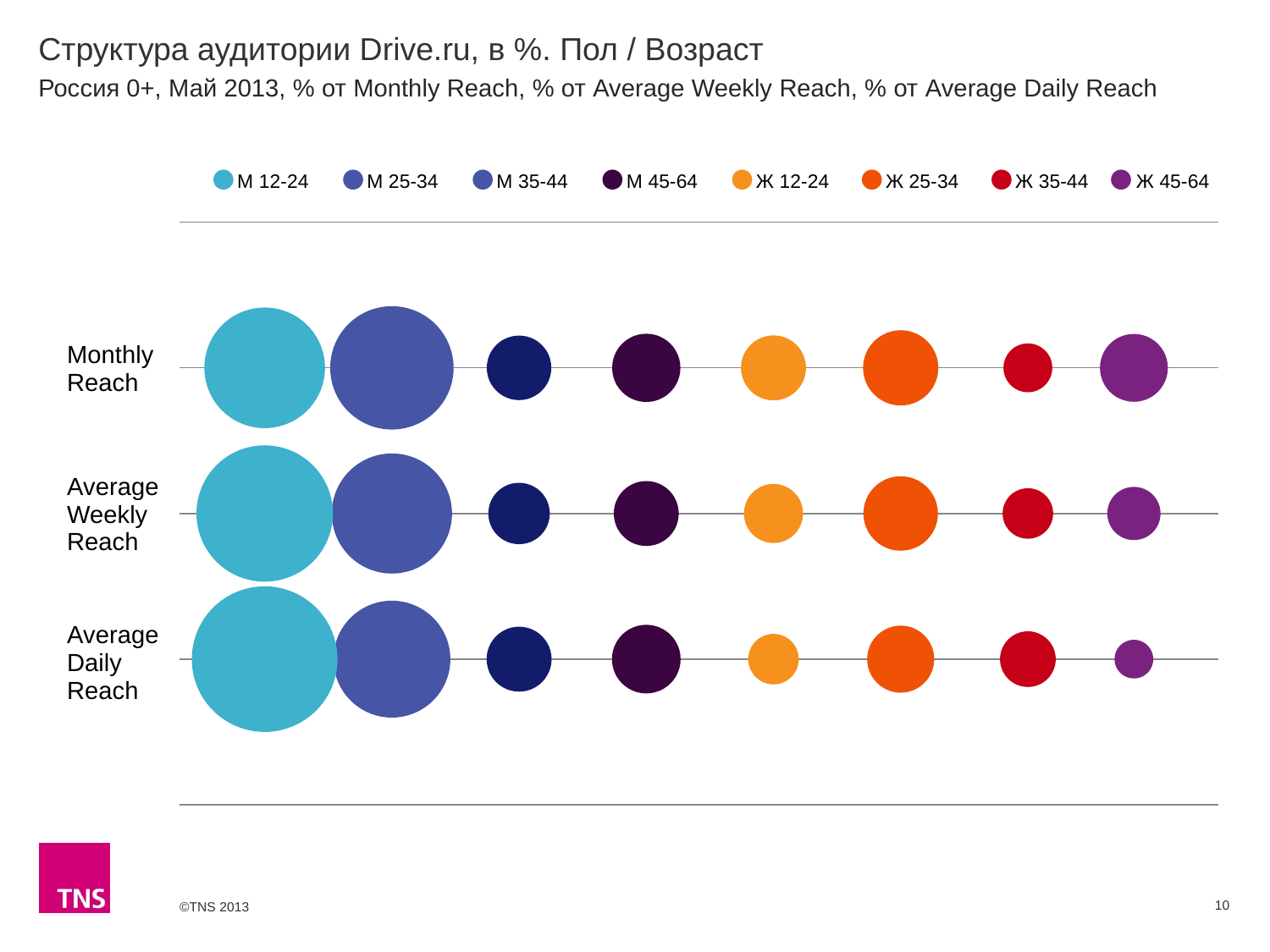
Does the bubble for Ж 45-64 grow or shrink going from Monthly Reach to Average Daily Reach? Shrink How many series does the legend list? 8 Which legend entry is listed first? М 12-24 Does the bubble for М 12-24 grow or shrink going from Monthly Reach to Average Daily Reach? Grow How many reach categories (rows) are plotted on the chart? 3 In the Monthly Reach row, which bubble is larger: М 12-24 or М 35-44? М 12-24 In the Average Daily Reach row, which group has the smallest bubble? Ж 45-64 In the Monthly Reach row, which group has the smallest bubble? Ж 35-44 What kind of chart is shown on the slide? Bubble chart In the Average Daily Reach row, which bubble is larger: Ж 25-34 or Ж 12-24? Ж 25-34 In the Average Daily Reach row, which group has the largest bubble? М 12-24 What is the title of the chart on the slide? Структура аудитории Drive.ru, в %. Пол / Возраст